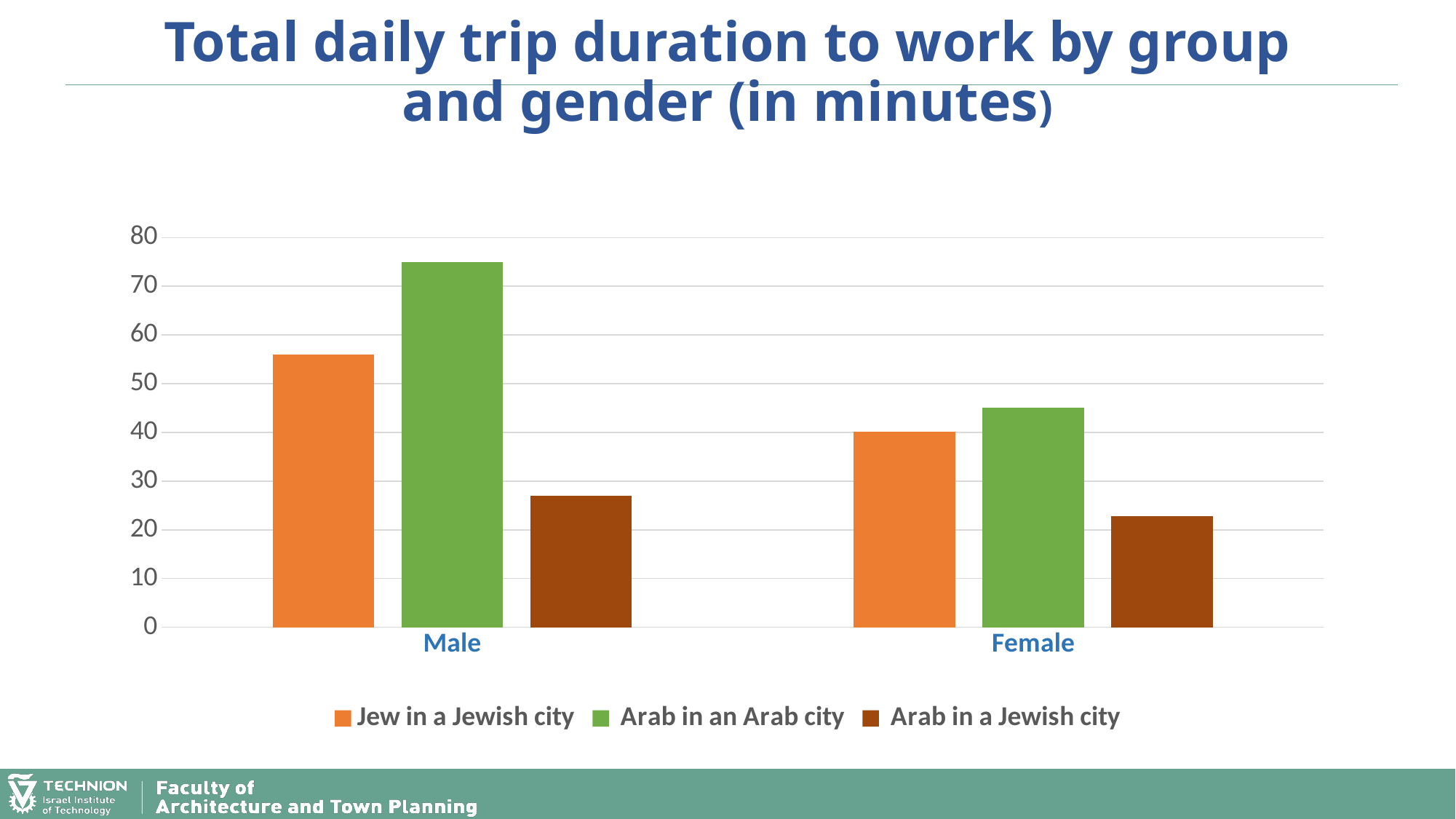
Which group has the lowest total daily trip duration among females? Arab in a Jewish city What kind of chart is shown on the slide? bar chart Is the value for Arab in a Jewish city females greater or less than 30? less Which group has the highest total daily trip duration among males? Arab in an Arab city Which is larger: the value for Arab in an Arab city males or Arab in an Arab city females? Arab in an Arab city males Is the value for Arab in an Arab city males greater or less than 70? greater What colour represents Arab in a Jewish city in the legend? brown Is the value for Arab in a Jewish city males greater or less than 30? less How many gender categories are shown on the x axis? 2 How many series does the legend list? 3 Which is larger: the value for Jew in a Jewish city females or Arab in a Jewish city females? Jew in a Jewish city females